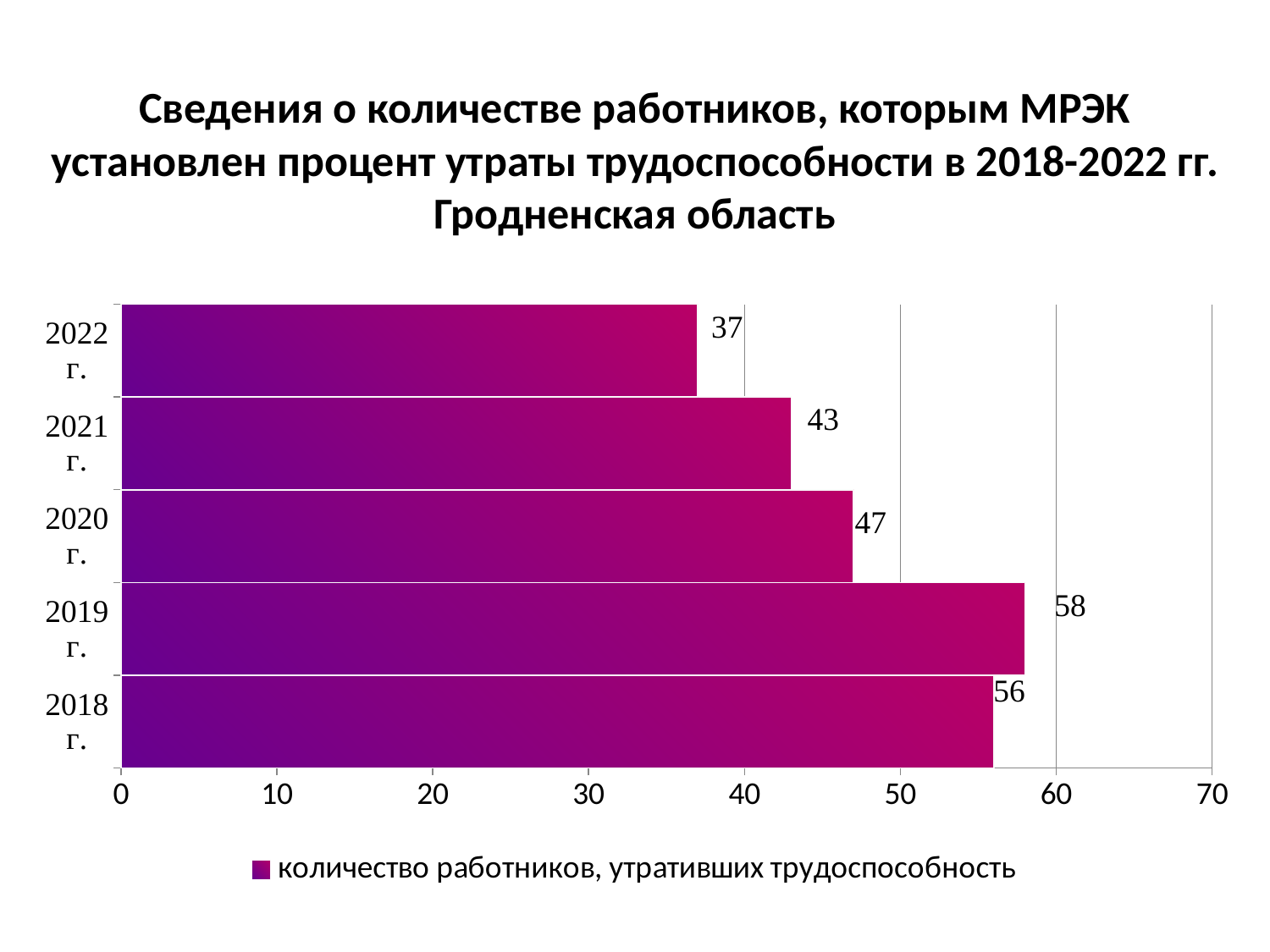
What is the value for 2019 г.? 58 What kind of chart is this? bar chart Is the value for 2021 г. greater or less than 40? greater Which year has the lowest value? 2022 г. How many years are shown on the chart? 5 What is the difference between the values for 2021 г. and 2020 г.? 4 What is the legend entry of the chart? количество работников, утративших трудоспособность What is the difference between the values for 2019 г. and 2022 г.? 21 What is the value for 2022 г.? 37 Which is larger, the value for 2018 г. or the value for 2020 г.? 2018 г. What is the value for 2018 г.? 56 Which year has the highest value? 2019 г.